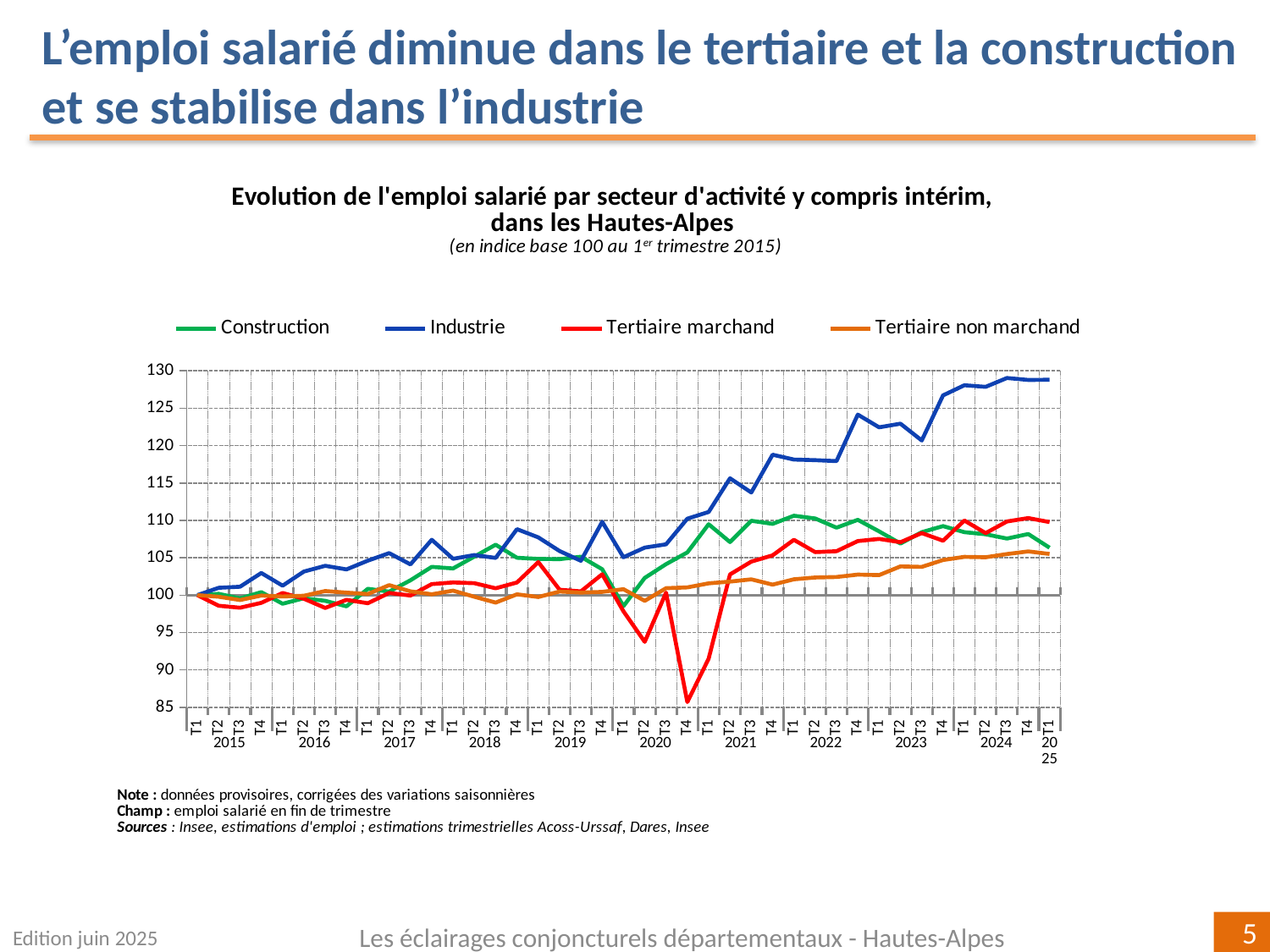
Is the value for Industrie at T1 2025 greater or less than 125? greater Which series has the highest value at T1 2025? Industrie Is the value for Tertiaire non marchand at T1 2025 greater or less than 110? less At T1 2025, which is larger: Industrie or Construction? Industrie Is the value for Construction at T1 2021 greater or less than 105? greater How many series does the legend list? 4 What kind of chart is shown on the slide? line chart Which series reaches the lowest value anywhere on the chart? Tertiaire marchand At T2 2020, which is larger: Industrie or Tertiaire marchand? Industrie Does the Industrie series rise or fall overall from T1 2015 to T1 2025? rise Which series are listed in the legend? Construction, Industrie, Tertiaire marchand, Tertiaire non marchand